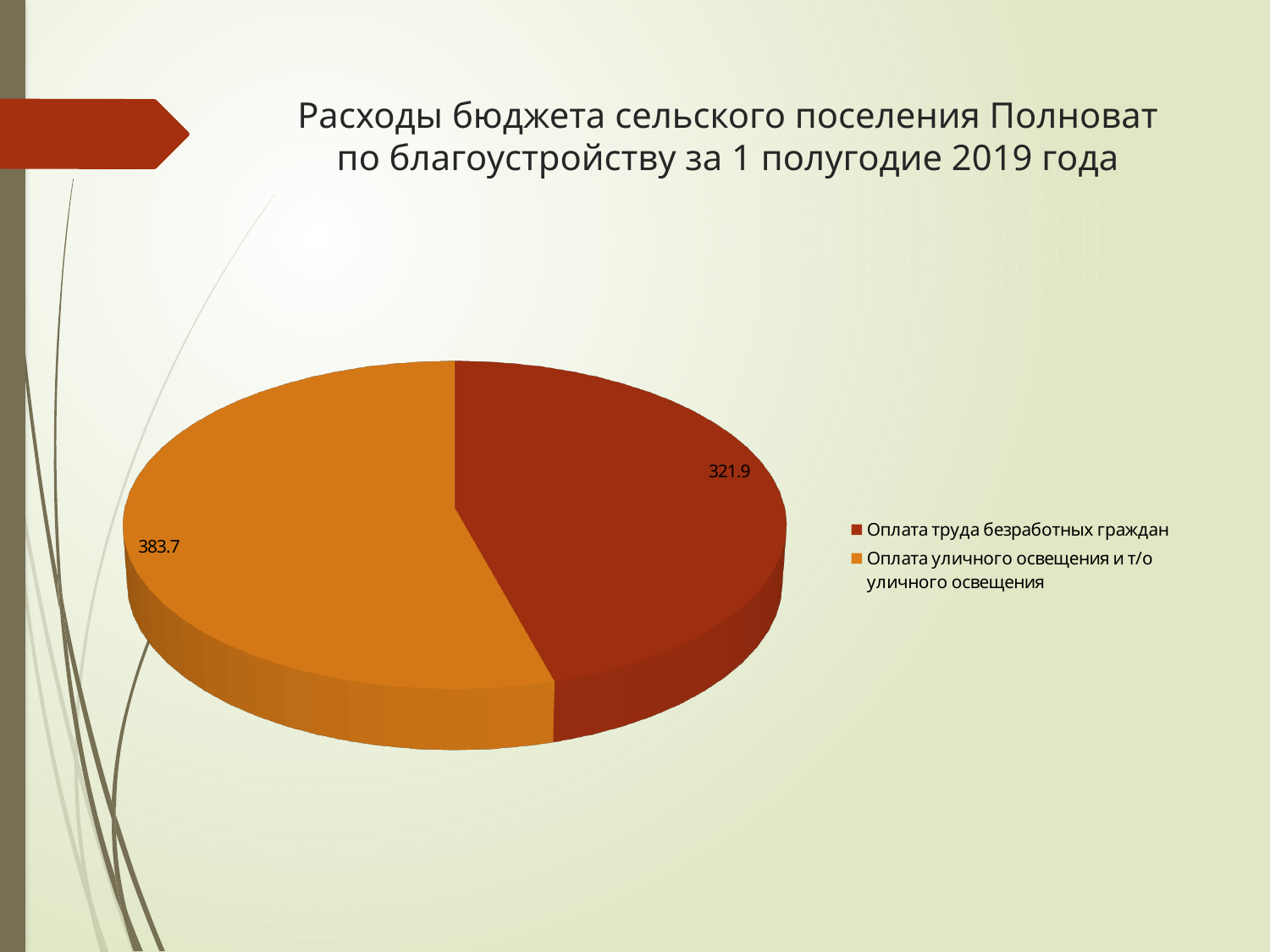
What is the value for "Оплата труда безработных граждан"? 321.9 How many entries does the legend list? 2 Which category has the largest slice of the pie? Оплата уличного освещения и т/о уличного освещения What is the title of the chart on the slide? Расходы бюджета сельского поселения Полноват по благоустройству за 1 полугодие 2019 года How many categories does the pie chart show? 2 What type of chart is shown on the slide? Pie chart What is the total of the two values shown on the pie chart? 705.6 What is the difference between the value for "Оплата уличного освещения и т/о уличного освещения" and the value for "Оплата труда безработных граждан"? 61.8 What is the value for "Оплата уличного освещения и т/о уличного освещения"? 383.7 What colour is the slice for "Оплата труда безработных граждан"? Dark red Which is larger: the value for "Оплата труда безработных граждан" or the value for "Оплата уличного освещения и т/о уличного освещения"? Оплата уличного освещения и т/о уличного освещения Which category has the smallest slice of the pie? Оплата труда безработных граждан